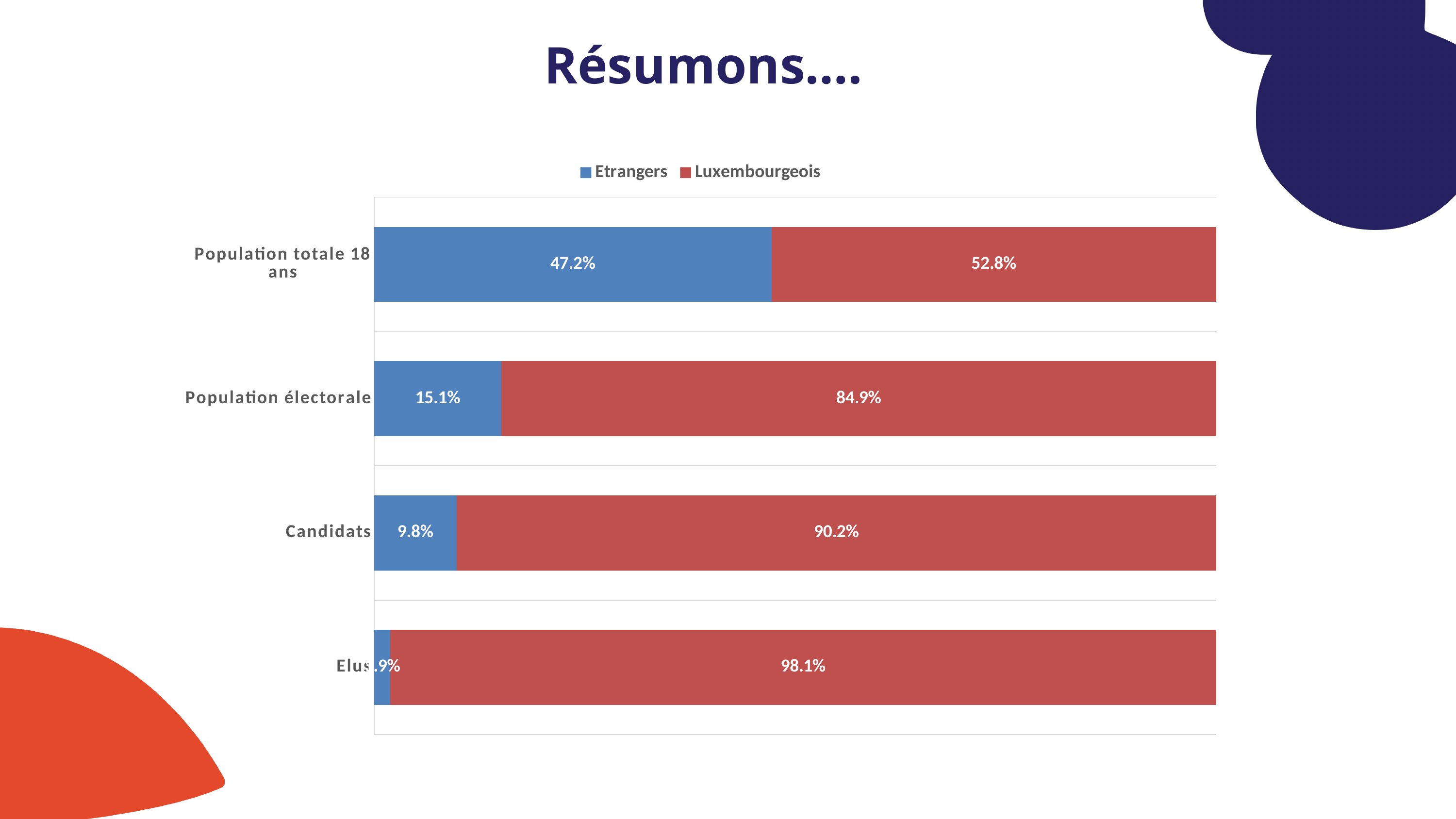
What is the Luxembourgeois value for Population électorale? 84.9% Which category has the highest Etrangers value? Population totale 18 ans What is the Etrangers value for Candidats? 9.8% What is the difference between the Luxembourgeois and Etrangers values for Candidats? 80.4% What is the Etrangers value for Population totale 18 ans? 47.2% Which is larger for Population électorale: the Etrangers value or the Luxembourgeois value? Luxembourgeois What type of chart is shown on the slide? Stacked bar chart What is the Luxembourgeois value for Elus? 98.1% Which category has the lowest Luxembourgeois value? Population totale 18 ans How many categories are shown on the chart? 4 How many series does the legend list? 2 What are the two series named in the legend? Etrangers and Luxembourgeois